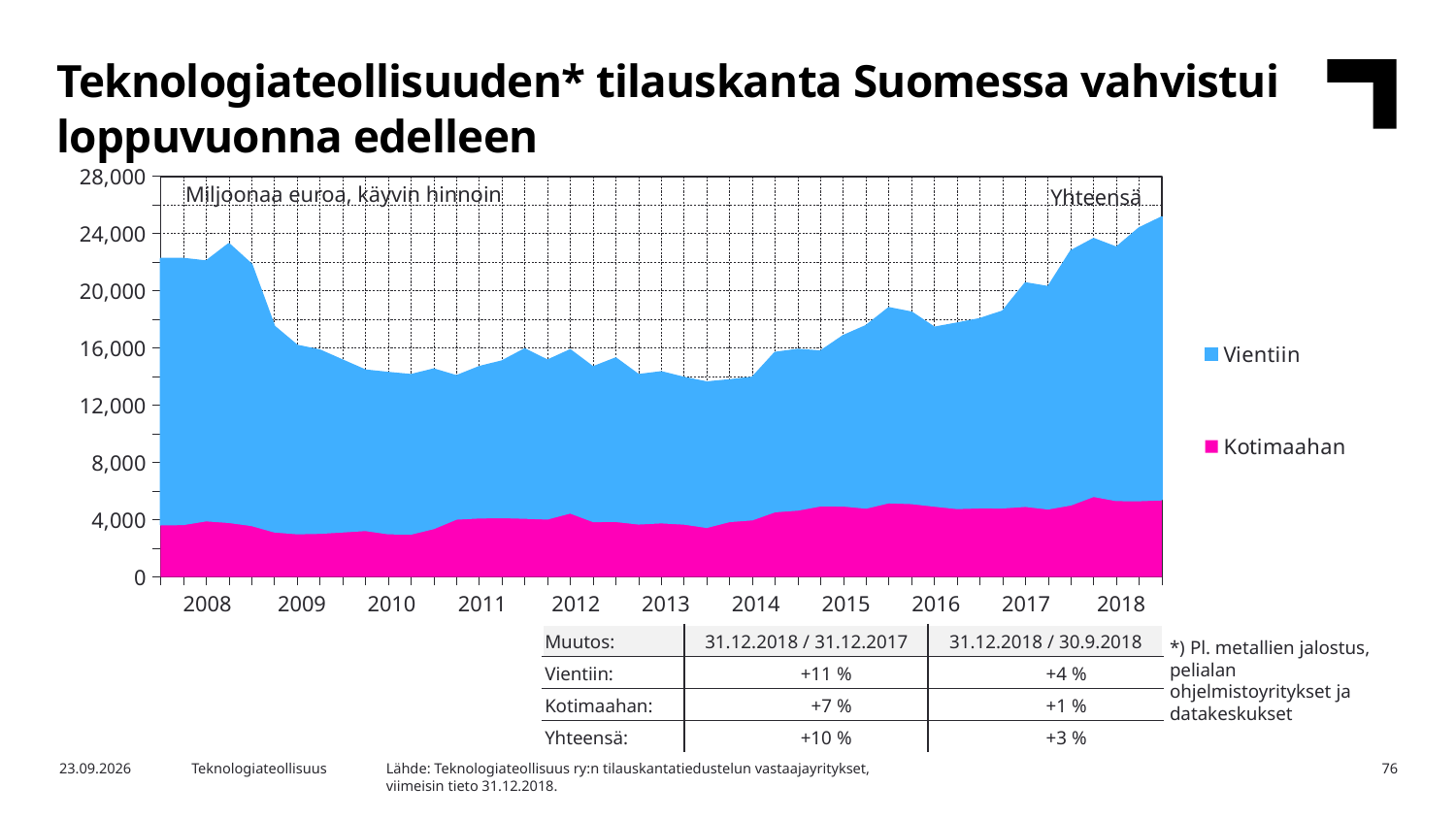
Is the Kotimaahan value at the end of 2018 greater or less than 4,000? greater According to the table below the chart, what is the change for Vientiin between 31.12.2017 and 31.12.2018? +11 % Which two series are listed in the chart legend? Vientiin and Kotimaahan How many series does the chart legend list? 2 Is the total (Yhteensä) value at the start of 2008 greater or less than 20,000? greater Is the total (Yhteensä) value at the end of 2018 greater or less than 24,000? greater Does the total order backlog rise or fall from 2008 to 2009? fall How many year labels are shown on the x axis? 11 What unit is stated in the label inside the chart area? Miljoonaa euroa, käyvin hinnoin Does the total order backlog rise or fall from 2014 to 2018? rise What kind of chart is shown on the slide? Area chart